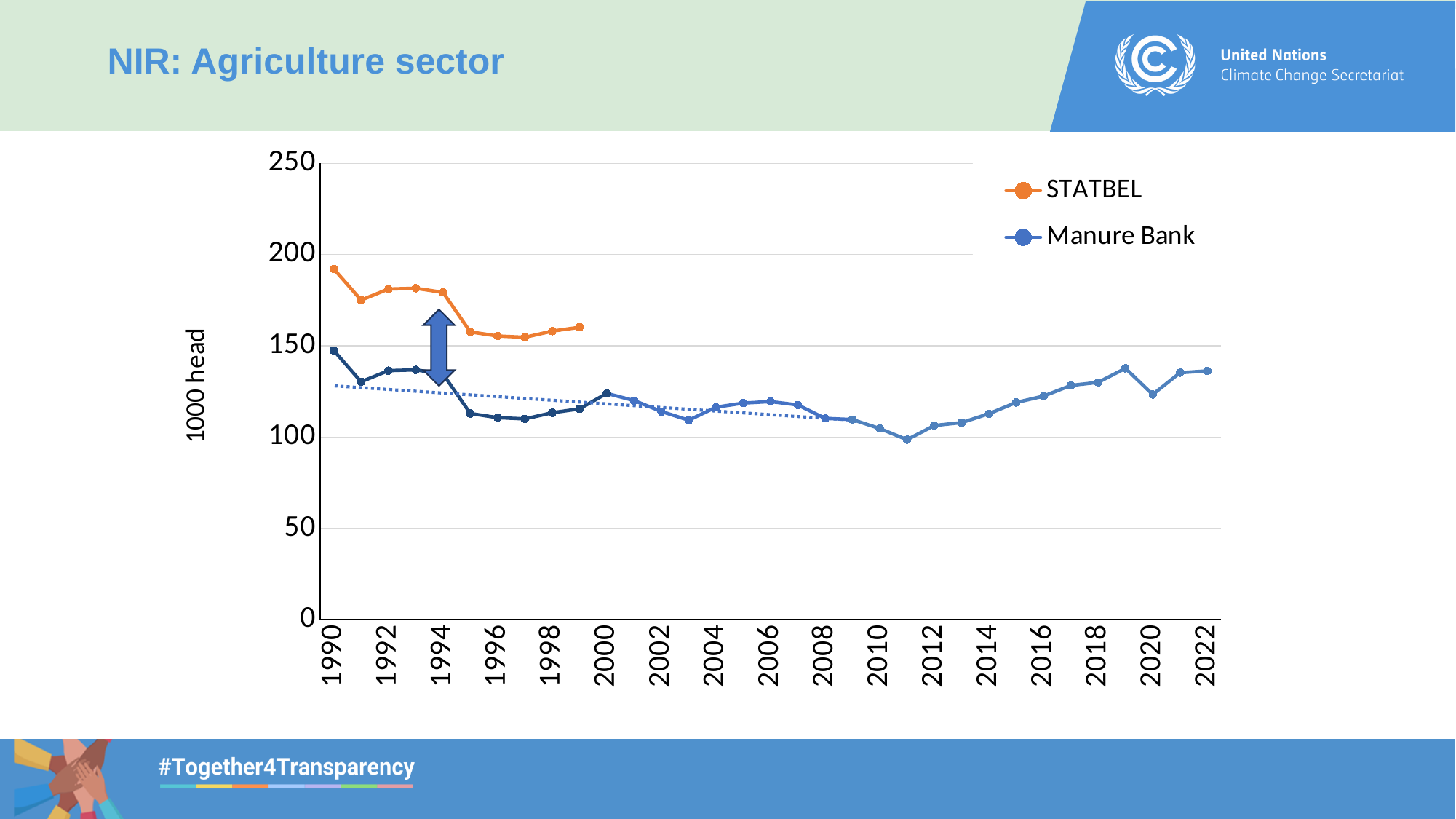
What are the two series named in the legend? STATBEL and Manure Bank Is the STATBEL value for 1990 greater or less than 200? less Does the Manure Bank series rise or fall between 2011 and 2019? rise How many series does the legend list? 2 Is the STATBEL value for 1990 greater or less than 150? greater In which year does the Manure Bank series reach its lowest value? 2011 What is the label on the vertical axis? 1000 head In which year does the STATBEL series reach its highest value? 1990 In 1990, which series has the larger value, STATBEL or Manure Bank? STATBEL What kind of chart is shown on the slide? line chart